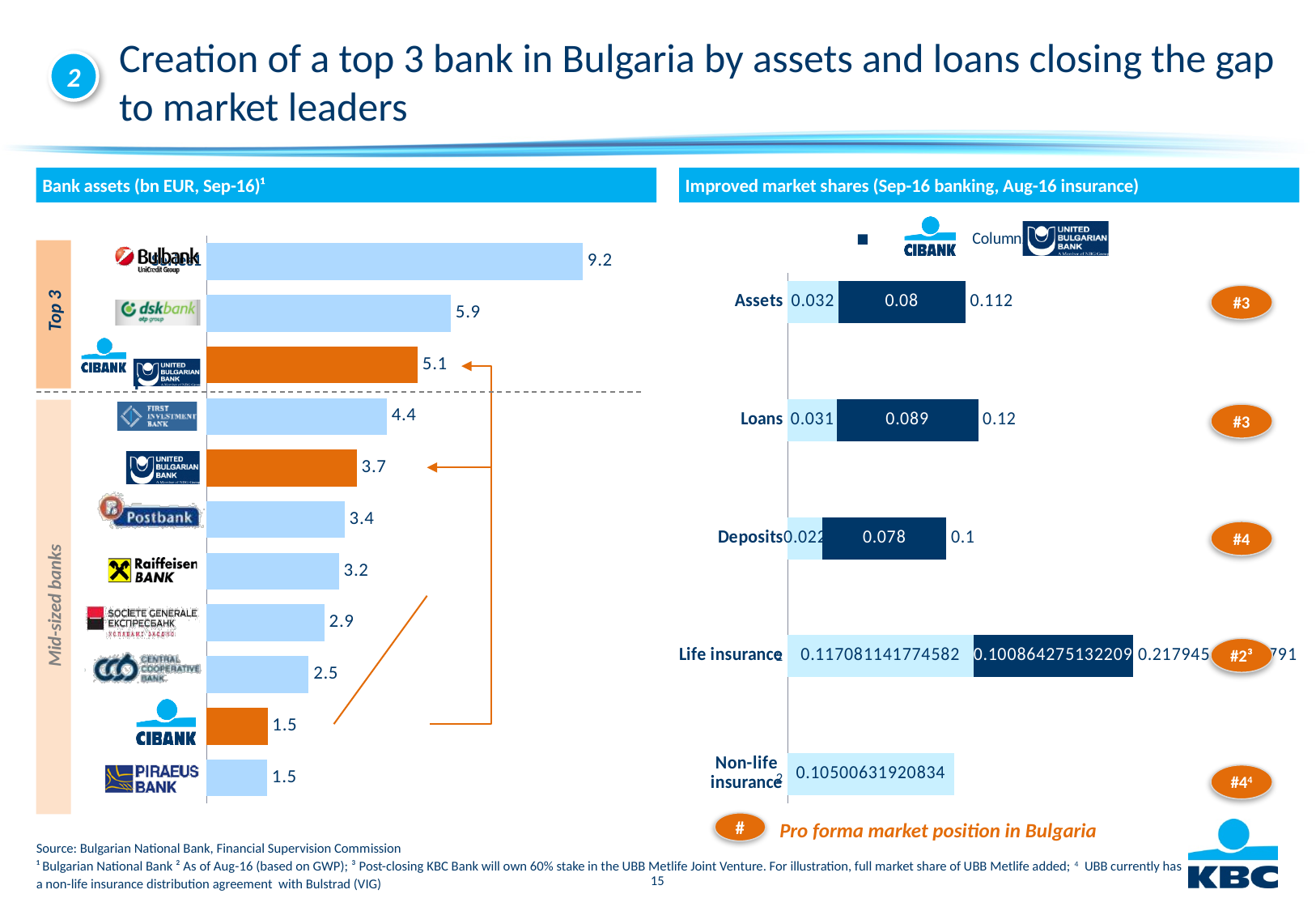
How many bars are shown in the Bank assets chart? 11 In the Bank assets chart, what is the value for Postbank? 3.4 How many series does the legend of the Improved market shares chart list? 3 What kind of chart is the Bank assets chart? Bar chart In the Improved market shares chart, which category has the highest CIBANK value? Life insurance In the Bank assets chart, what is the difference between Bulbank and DSK bank? 3.3 In the Improved market shares chart, what is the CIBANK value for Assets? 0.032 In the Bank assets chart, which is larger: First Investment Bank or Raiffeisen Bank? First Investment Bank In the Improved market shares chart, what is the United Bulgarian Bank value for Loans? 0.089 In the Improved market shares chart, what is the total of the Deposits bar? 0.1 In the Bank assets chart, which bank has the highest assets? Bulbank In the Bank assets chart, what is the value for Bulbank? 9.2